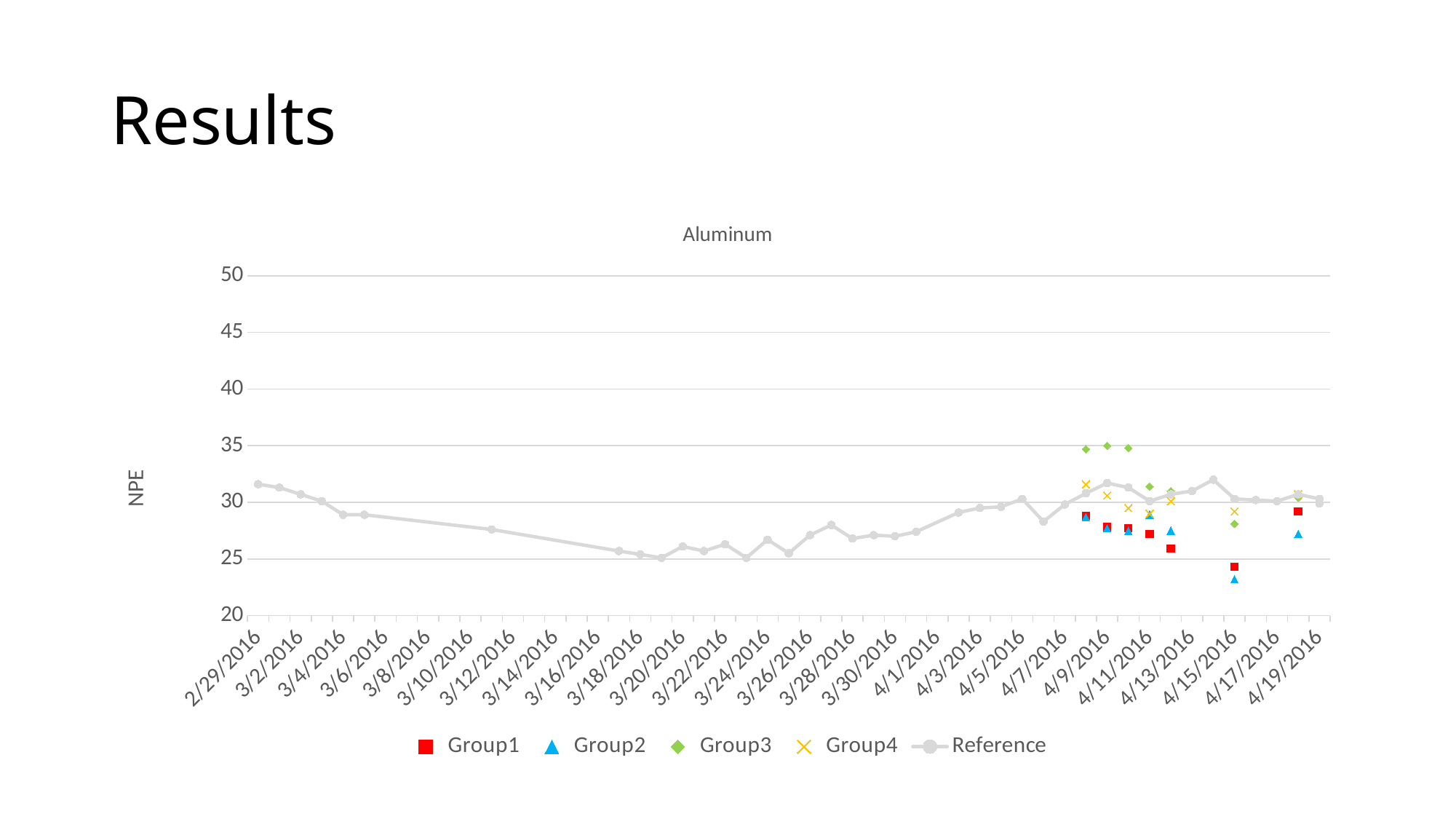
How many series does the legend list? 5 Is the Reference value on 2/29/2016 greater or less than 30? greater What is the title of the chart? Aluminum Which series has the highest plotted point on the chart? Group3 Is the Group1 value on 4/15/2016 greater or less than 25? less What kind of chart is shown on the slide? Line chart with scatter markers Is the Group3 value on 4/15/2016 greater or less than 30? less Does the Reference series rise or fall between 2/29/2016 and 3/20/2016? fall Which series is drawn as a continuous line rather than isolated markers? Reference On 4/9/2016, which is higher: Group3 or Group1? Group3 What is the label on the vertical axis? NPE